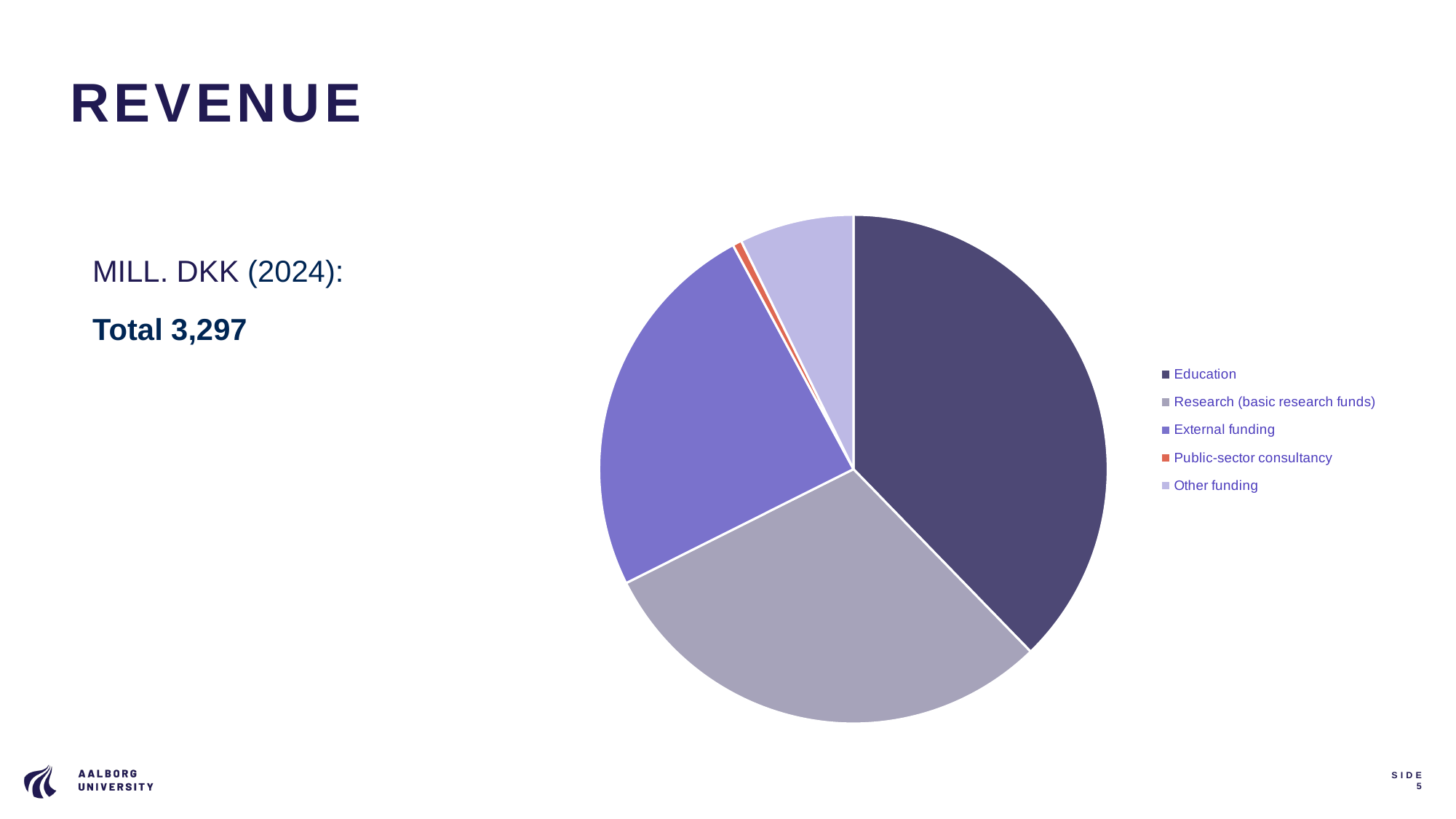
What total revenue in mill. DKK is stated on the slide for 2024? 3,297 Which slice is larger, Research (basic research funds) or External funding? Research (basic research funds) What kind of chart is shown on the slide? pie chart What is the title of the slide containing the pie chart? REVENUE Which slice is larger, Education or Other funding? Education How many slices does the pie chart have? 5 Which legend entry is shown in red/orange? Public-sector consultancy How many entries does the legend list? 5 Which category has the smallest slice of the pie chart? Public-sector consultancy Which slice is larger, External funding or Public-sector consultancy? External funding Which category has the largest slice of the pie chart? Education